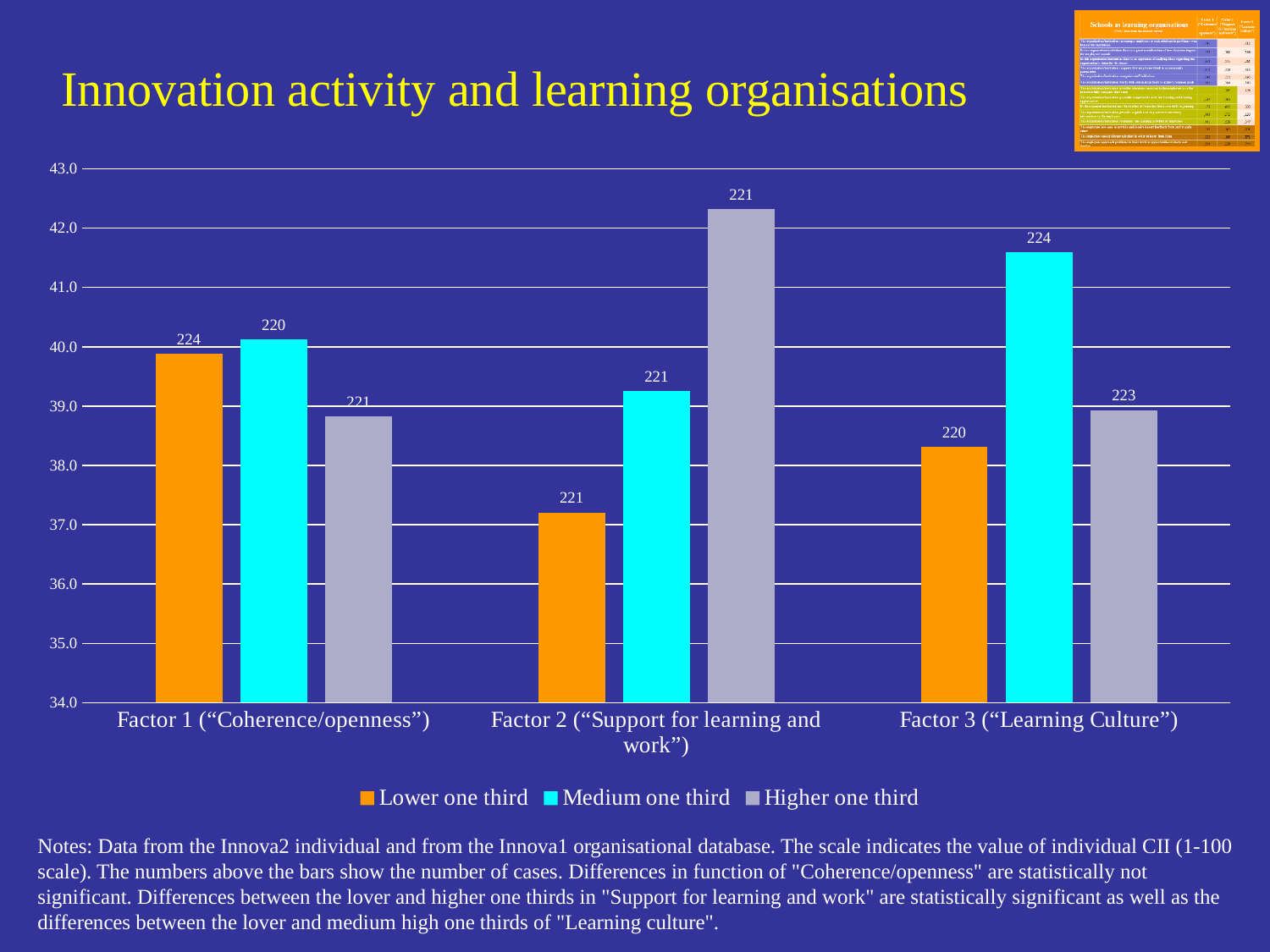
Which series has the shortest bar for Factor 2 ("Support for learning and work")? Lower one third How many series does the legend list? 3 Is the value for Medium one third in Factor 3 ("Learning Culture") greater or less than 41? greater How many factor categories are shown on the x axis? 3 Is the value for Higher one third in Factor 2 ("Support for learning and work") greater or less than 42? greater Which series has the tallest bar for Factor 2 ("Support for learning and work")? Higher one third Is the value for Lower one third in Factor 2 ("Support for learning and work") greater or less than 38? less What number of cases is printed above the Lower one third bar for Factor 1 ("Coherence/openness")? 224 What kind of chart is shown on the slide? Bar chart What is the title of the chart? Innovation activity and learning organisations Which series has the tallest bar for Factor 3 ("Learning Culture")? Medium one third Which is larger: the Higher one third bar for Factor 2 or the Medium one third bar for Factor 3? Higher one third bar for Factor 2